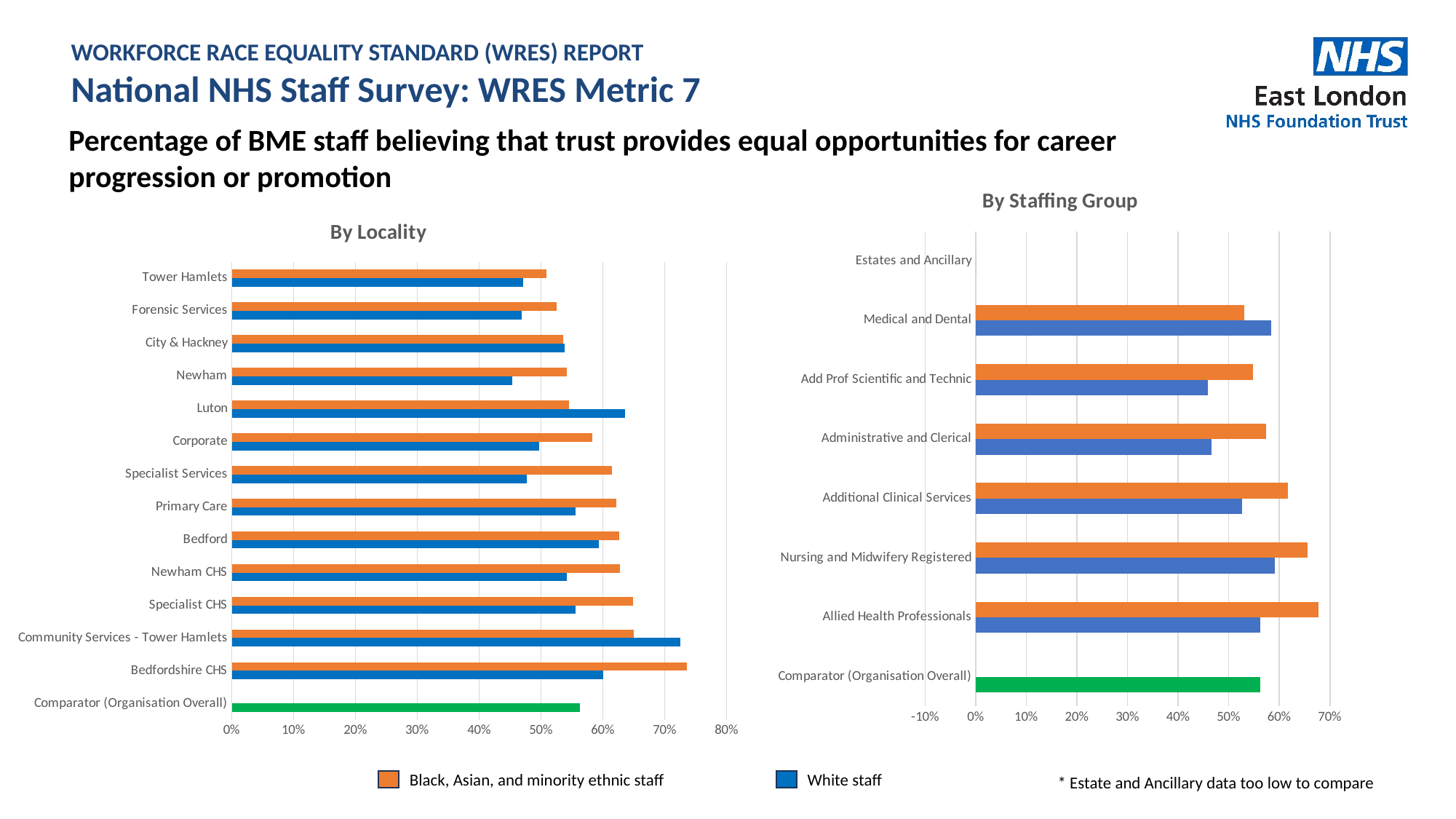
On the "By Staffing Group" chart, is the White staff value for Add Prof Scientific and Technic greater or less than 50%? less On the "By Locality" chart, is the White staff value for Newham greater or less than 50%? less What kind of chart is the "By Locality" chart? bar chart How many categories are shown on the "By Locality" chart? 14 On the "By Locality" chart, which locality has the highest value for Black, Asian, and minority ethnic staff? Bedfordshire CHS On the "By Staffing Group" chart, for Medical and Dental, which is larger: the value for White staff or for Black, Asian, and minority ethnic staff? White staff How many series does the legend at the bottom of the slide list? 2 On the "By Locality" chart, which locality has the highest value for White staff? Community Services - Tower Hamlets On the "By Locality" chart, for Specialist Services, which is larger: the value for Black, Asian, and minority ethnic staff or for White staff? Black, Asian, and minority ethnic staff How many categories are shown on the "By Staffing Group" chart? 8 On the "By Locality" chart, is the White staff value for Luton greater or less than 60%? greater On the "By Staffing Group" chart, which staffing group has the highest value for Black, Asian, and minority ethnic staff? Allied Health Professionals